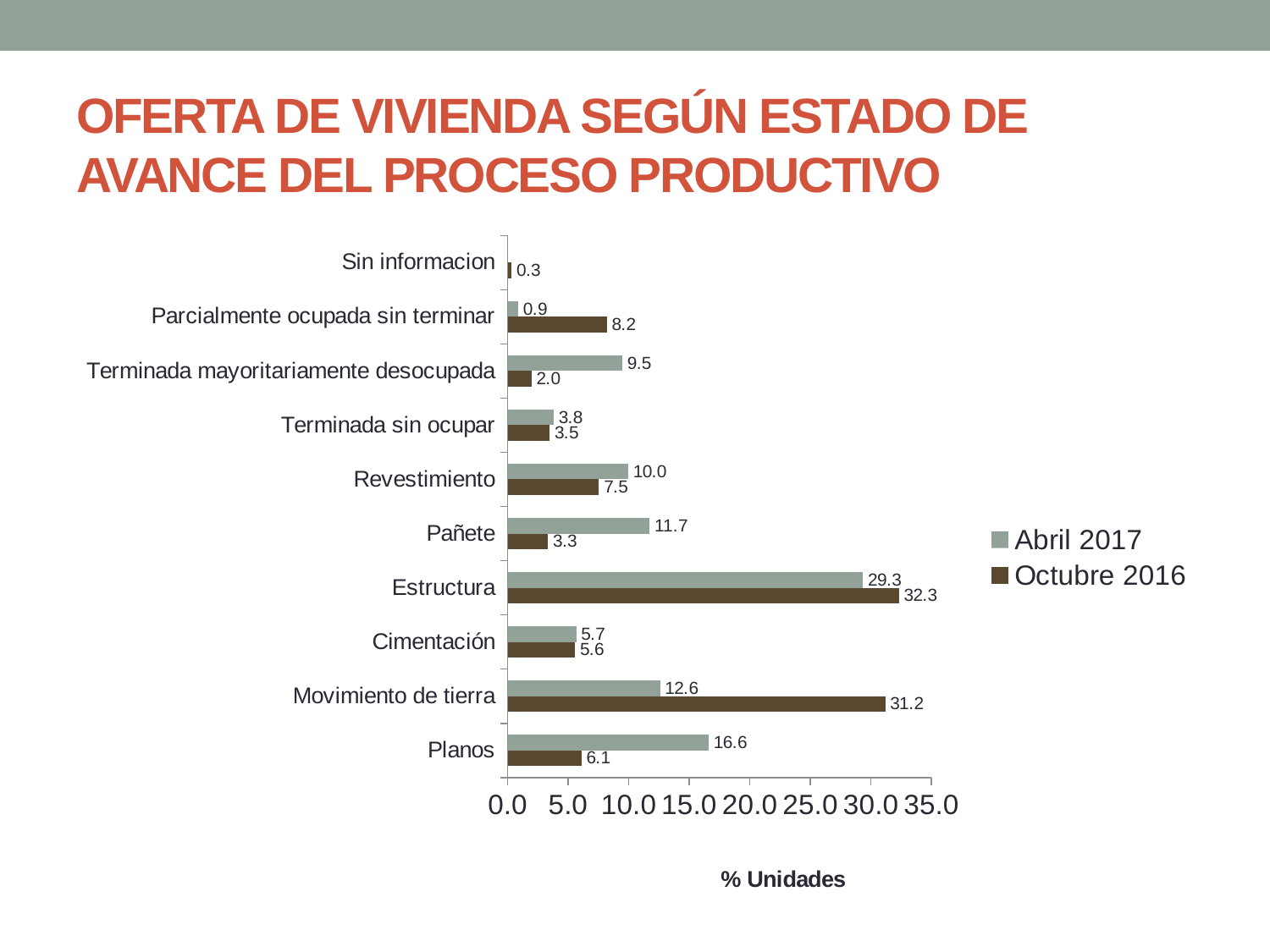
How many categories are shown on the y axis of the chart? 10 What is the value for Estructura in the Abril 2017 series? 29.3 Which category has the highest value in the Octubre 2016 series? Estructura What is the value for Parcialmente ocupada sin terminar in the Octubre 2016 series? 8.2 What is the value for Planos in the Abril 2017 series? 16.6 What is the label of the x axis of the chart? % Unidades What is the difference between the Octubre 2016 and Abril 2017 values for Movimiento de tierra? 18.6 Which category has the lowest value in the Abril 2017 series? Parcialmente ocupada sin terminar Which is larger for Pañete: the Abril 2017 value or the Octubre 2016 value? Abril 2017 What is the value for Movimiento de tierra in the Octubre 2016 series? 31.2 What kind of chart is shown on the slide? Bar chart How many series does the legend list? 2